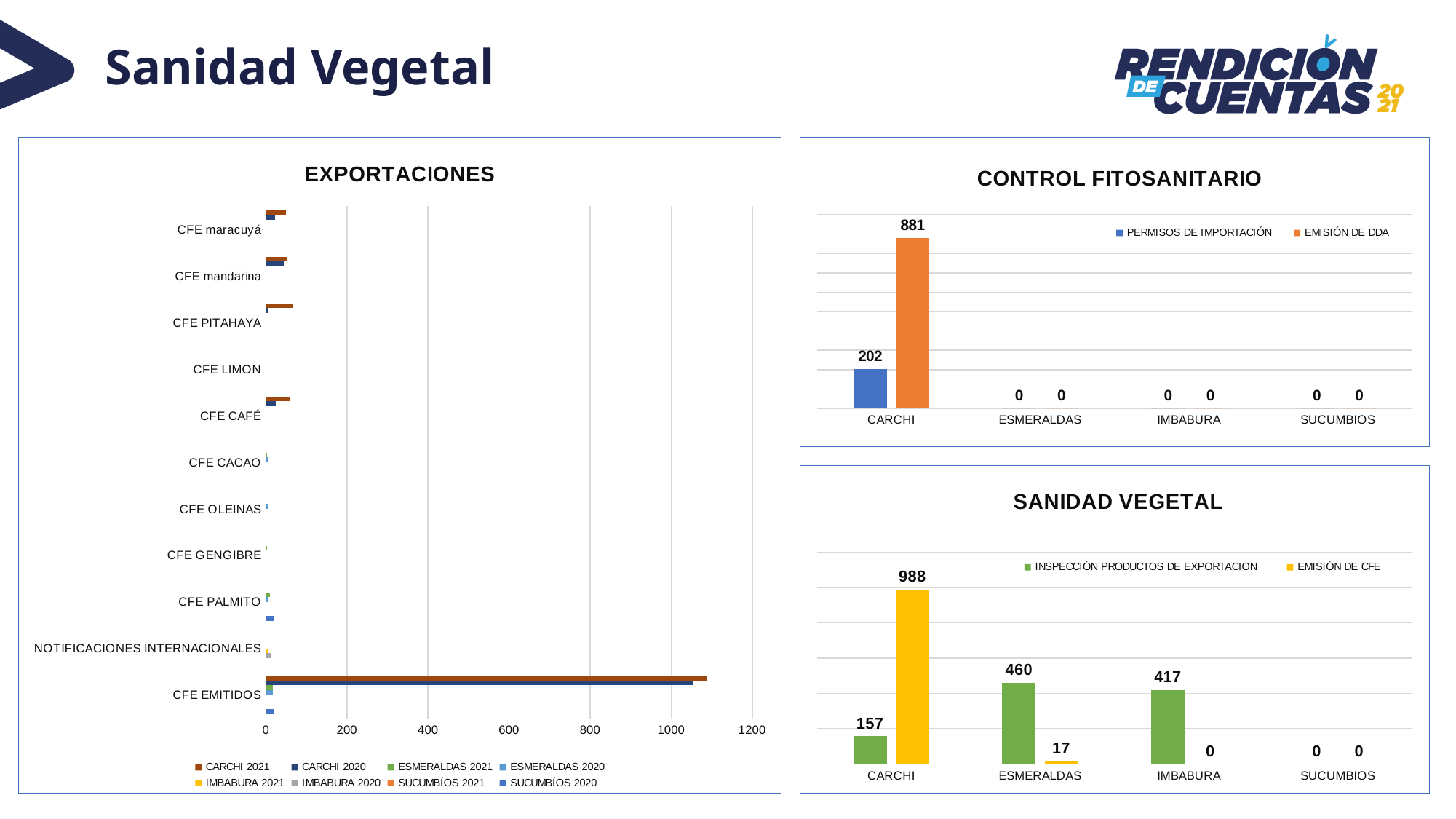
In the CONTROL FITOSANITARIO chart, what is the difference between EMISIÓN DE DDA and PERMISOS DE IMPORTACIÓN for CARCHI? 679 In the SANIDAD VEGETAL chart, what is the difference between INSPECCIÓN PRODUCTOS DE EXPORTACION for ESMERALDAS and IMBABURA? 43 In the CONTROL FITOSANITARIO chart, what is the value of EMISIÓN DE DDA for CARCHI? 881 In the SANIDAD VEGETAL chart, what is the value of INSPECCIÓN PRODUCTOS DE EXPORTACION for IMBABURA? 417 In the EXPORTACIONES chart, how many series does the legend list? 8 In the SANIDAD VEGETAL chart, which province has the highest value for INSPECCIÓN PRODUCTOS DE EXPORTACION? ESMERALDAS In the SANIDAD VEGETAL chart, which is larger: EMISIÓN DE CFE for CARCHI or for ESMERALDAS? CARCHI In the CONTROL FITOSANITARIO chart, what is the value of PERMISOS DE IMPORTACIÓN for CARCHI? 202 In the EXPORTACIONES chart, is the value of CARCHI 2021 for CFE EMITIDOS greater or less than 1000? greater In the SANIDAD VEGETAL chart, how many provinces are shown on the x axis? 4 In the SANIDAD VEGETAL chart, what is the value of EMISIÓN DE CFE for CARCHI? 988 In the CONTROL FITOSANITARIO chart, how many series does the legend list? 2